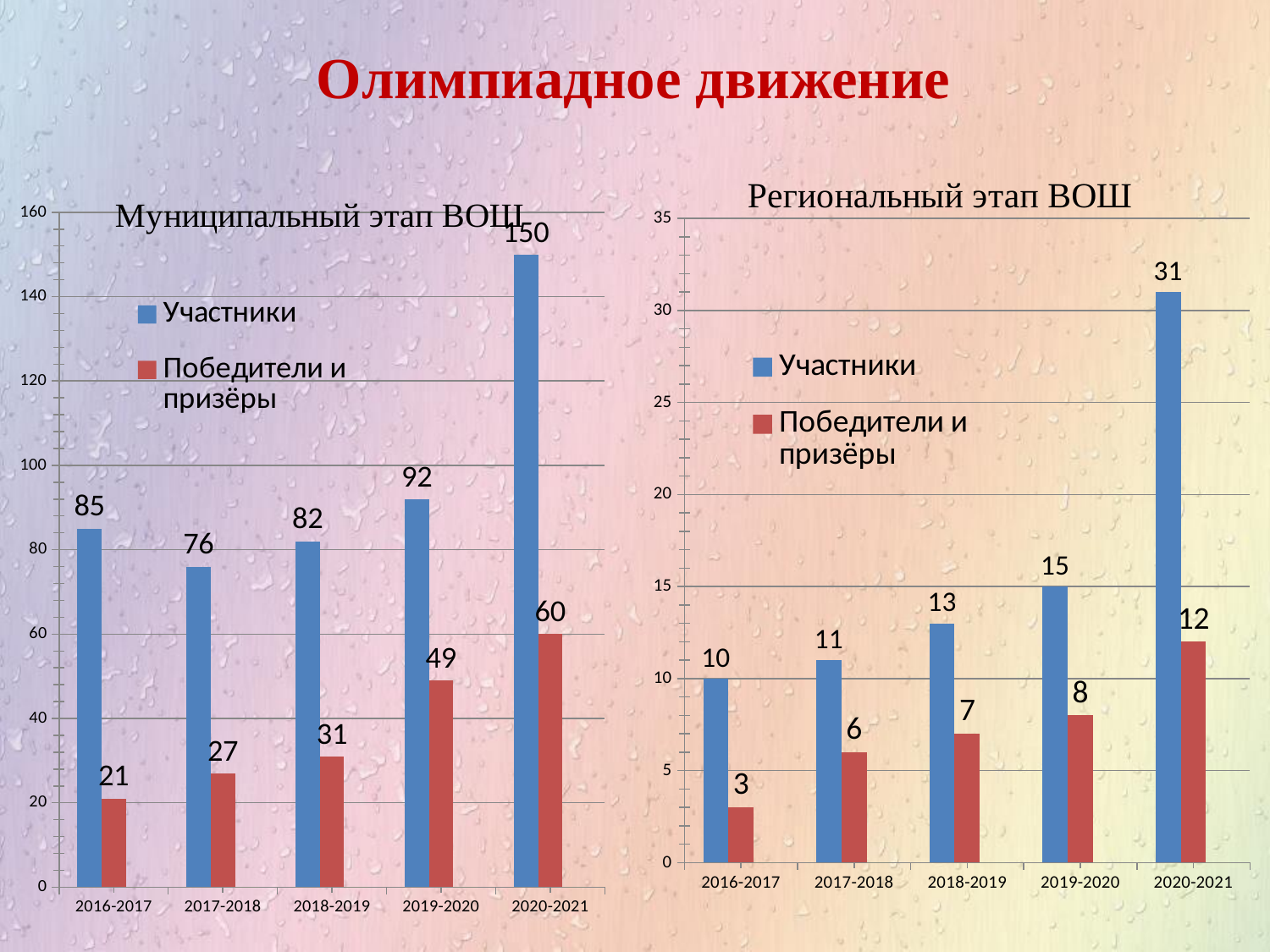
In the 'Региональный этап ВОШ' chart, what is the value for Участники in 2019-2020? 15 How many years are shown on the x axis of the 'Региональный этап ВОШ' chart? 5 In the 'Региональный этап ВОШ' chart, what is the value for Победители и призёры in 2016-2017? 3 In the 'Муниципальный этап ВОШ' chart, which is larger: Участники in 2016-2017 or Участники in 2018-2019? 2016-2017 In the 'Региональный этап ВОШ' chart, which year has the highest value for Победители и призёры? 2020-2021 In the 'Региональный этап ВОШ' chart, what is the difference between Участники in 2020-2021 and Участники in 2019-2020? 16 How many series does the legend of the 'Муниципальный этап ВОШ' chart list? 2 In the 'Муниципальный этап ВОШ' chart, what is the value for Победители и призёры in 2018-2019? 31 What type of chart is the 'Региональный этап ВОШ' chart? Bar chart In the 'Муниципальный этап ВОШ' chart, what is the difference between Участники and Победители и призёры in 2019-2020? 43 In the 'Муниципальный этап ВОШ' chart, which year has the lowest value for Участники? 2017-2018 In the 'Муниципальный этап ВОШ' chart, what is the value for Участники in 2020-2021? 150